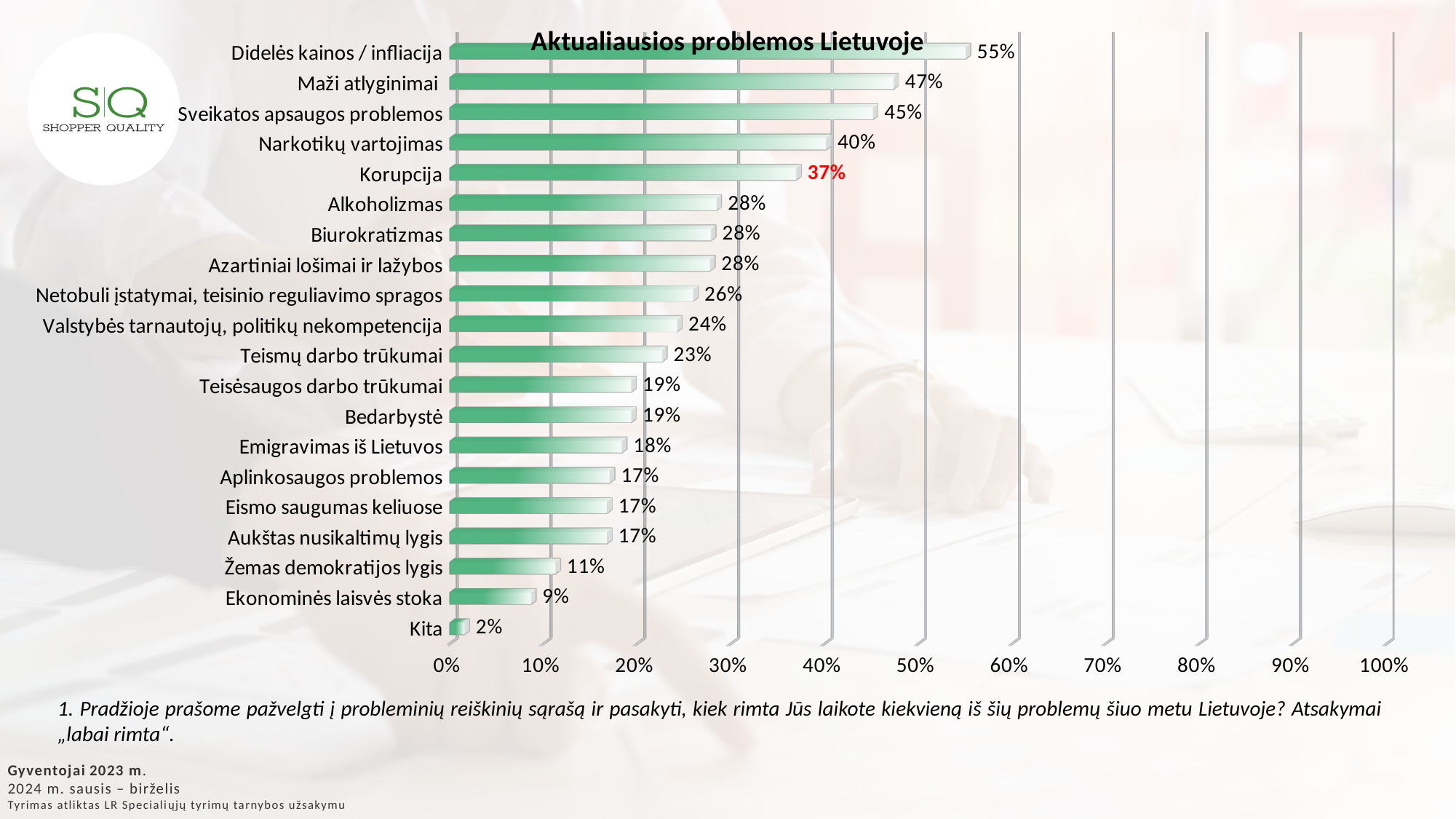
What is the value for Korupcija? 37% What kind of chart is shown on the slide? bar chart How many categories are shown in the chart? 20 Which category has the lowest value? Kita Is the value for Alkoholizmas greater or less than 30%? less Which category has the highest value? Didelės kainos / infliacija What is the title of the chart? Aktualiausios problemos Lietuvoje What is the value for Ekonominės laisvės stoka? 9% What is the value for Narkotikų vartojimas? 40% What is the difference between the values for Didelės kainos / infliacija and Maži atlyginimai? 8% What is the difference between the values for Sveikatos apsaugos problemos and Korupcija? 8% Which is larger, the value for Teismų darbo trūkumai or the value for Emigravimas iš Lietuvos? Teismų darbo trūkumai